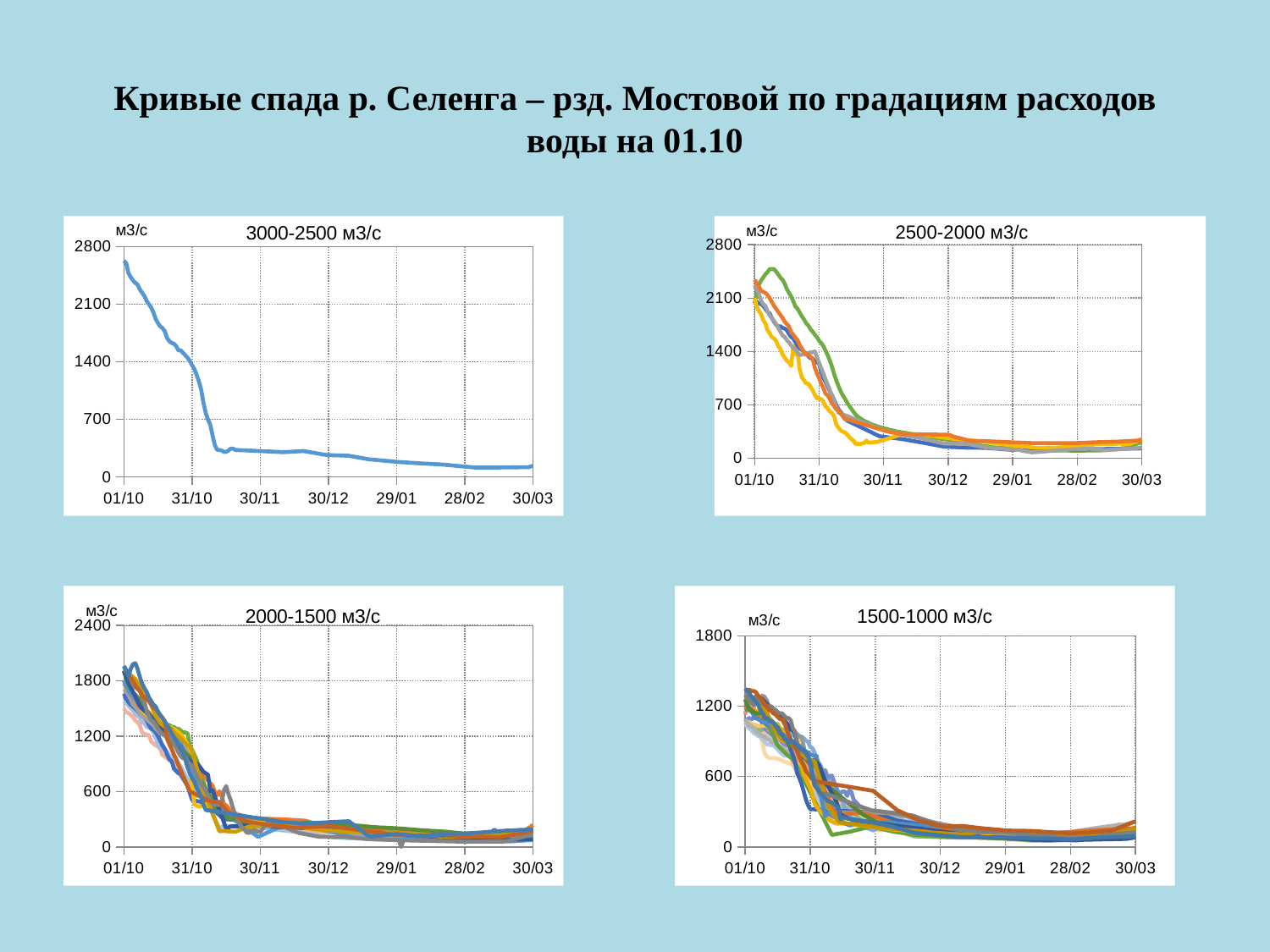
In the '3000-2500 м3/с' chart, do the values rise or fall from 01/10 to 30/03? fall In the '2500-2000 м3/с' chart, is the peak of the green line greater or less than 2100? greater In the '3000-2500 м3/с' chart, is the value at 01/10 greater or less than 2100? greater What unit is shown on the y axis of the charts? м3/с How many charts are on the slide? 4 What kind of chart is the '3000-2500 м3/с' chart? line chart How many date labels are on the x axis of the '3000-2500 м3/с' chart? 7 In the '3000-2500 м3/с' chart, is the value at 30/03 greater or less than 700? less What is the title of the top-right chart? 2500-2000 м3/с In the '1500-1000 м3/с' chart, do the lines rise or fall along the x axis? fall